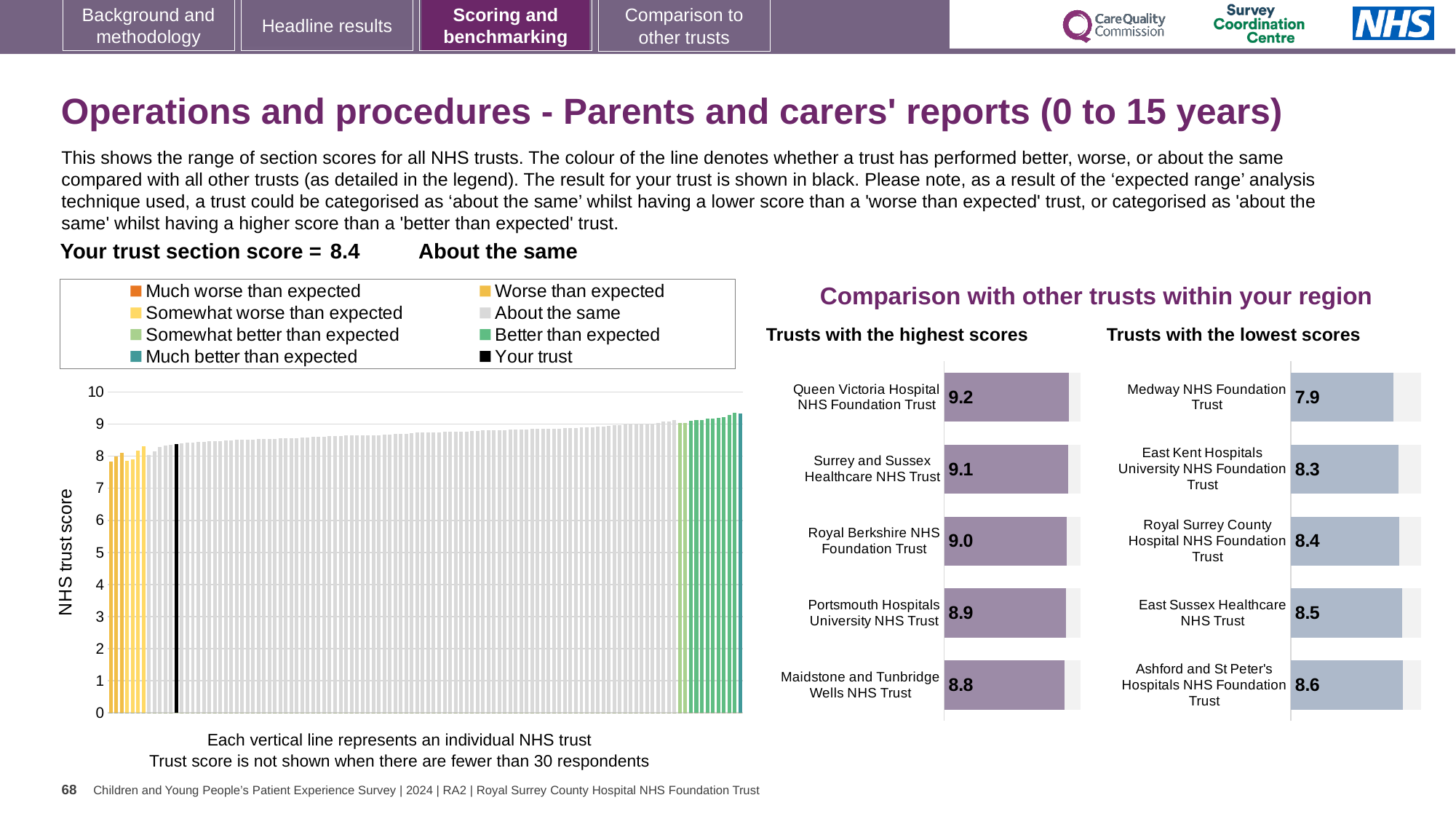
How many trusts are shown in the 'Trusts with the highest scores' chart? 5 In the NHS trust score chart on the left, what is the section score for your trust? 8.4 In the NHS trust score chart on the left, do the bar values rise or fall from left to right? rise How many entries does the legend above the NHS trust score chart list? 8 In the 'Trusts with the lowest scores' chart, which has the higher score: East Kent Hospitals University NHS Foundation Trust or Royal Surrey County Hospital NHS Foundation Trust? Royal Surrey County Hospital NHS Foundation Trust In the 'Trusts with the highest scores' chart, what is the difference between the scores of Queen Victoria Hospital NHS Foundation Trust and Maidstone and Tunbridge Wells NHS Trust? 0.4 In the 'Trusts with the highest scores' chart, which trust has the lowest score? Maidstone and Tunbridge Wells NHS Trust In the 'Trusts with the lowest scores' chart, what is the score for Medway NHS Foundation Trust? 7.9 In the NHS trust score chart on the left, is the value for your trust (black bar) greater or less than 8? greater In the 'Trusts with the highest scores' chart, what is the score for Queen Victoria Hospital NHS Foundation Trust? 9.2 In the 'Trusts with the lowest scores' chart, which trust has the highest score? Ashford and St Peter's Hospitals NHS Foundation Trust In the 'Trusts with the lowest scores' chart, what is the difference between the scores of East Sussex Healthcare NHS Trust and Medway NHS Foundation Trust? 0.6